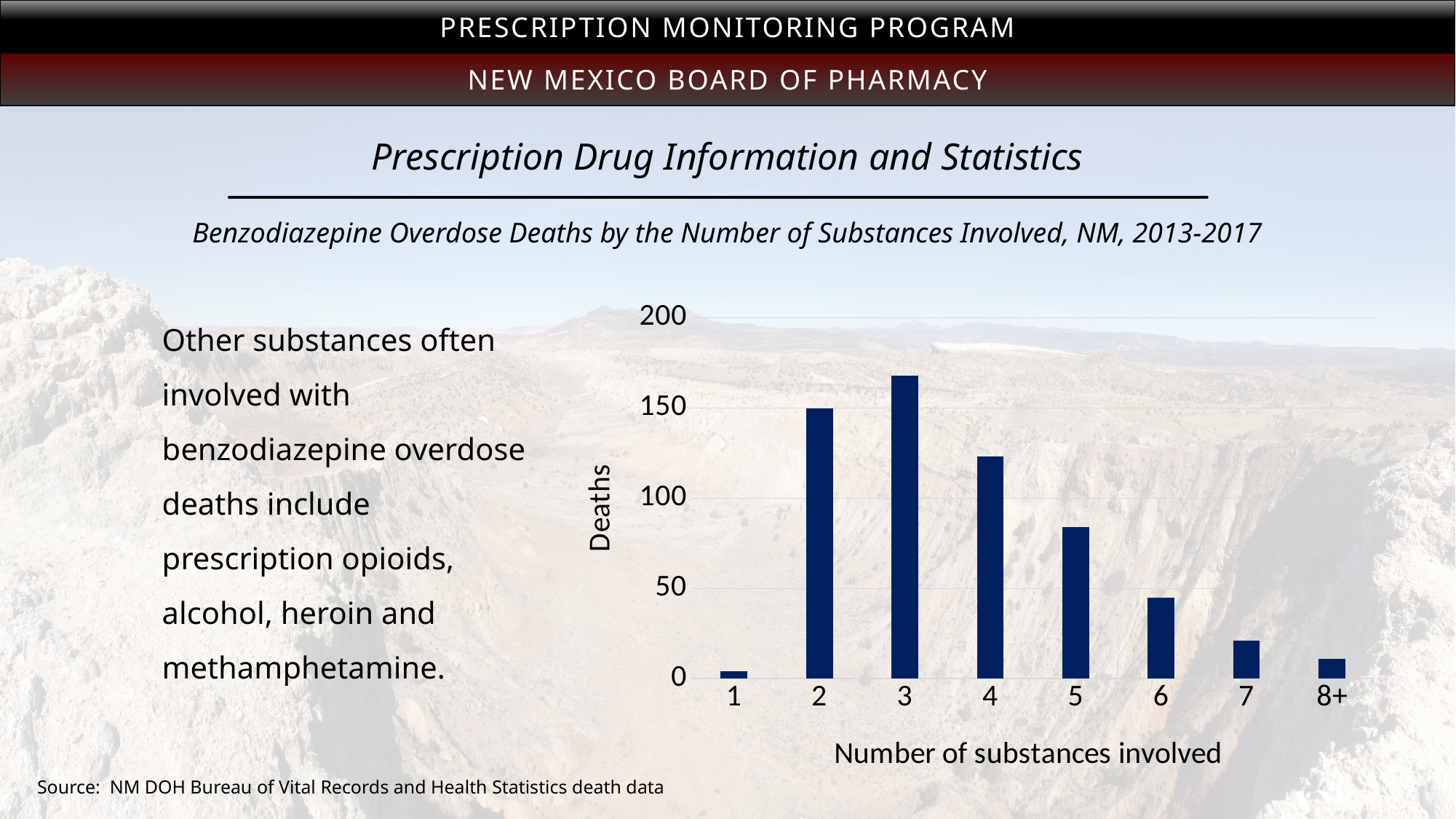
Which number of substances involved has the highest number of deaths? 3 What is the label of the x axis? Number of substances involved Which has more deaths: 5 substances or 6 substances? 5 Is the number of deaths for 4 substances greater or less than 100? greater How many categories are shown on the x axis? 8 Is the number of deaths for 7 substances greater or less than 50? less Is the number of deaths for 5 substances greater or less than 100? less Which number of substances involved has the lowest number of deaths? 1 How do the deaths change from 3 substances through 8+ substances? they fall What kind of chart is shown on the slide? bar chart Which has more deaths: 2 substances or 4 substances? 2